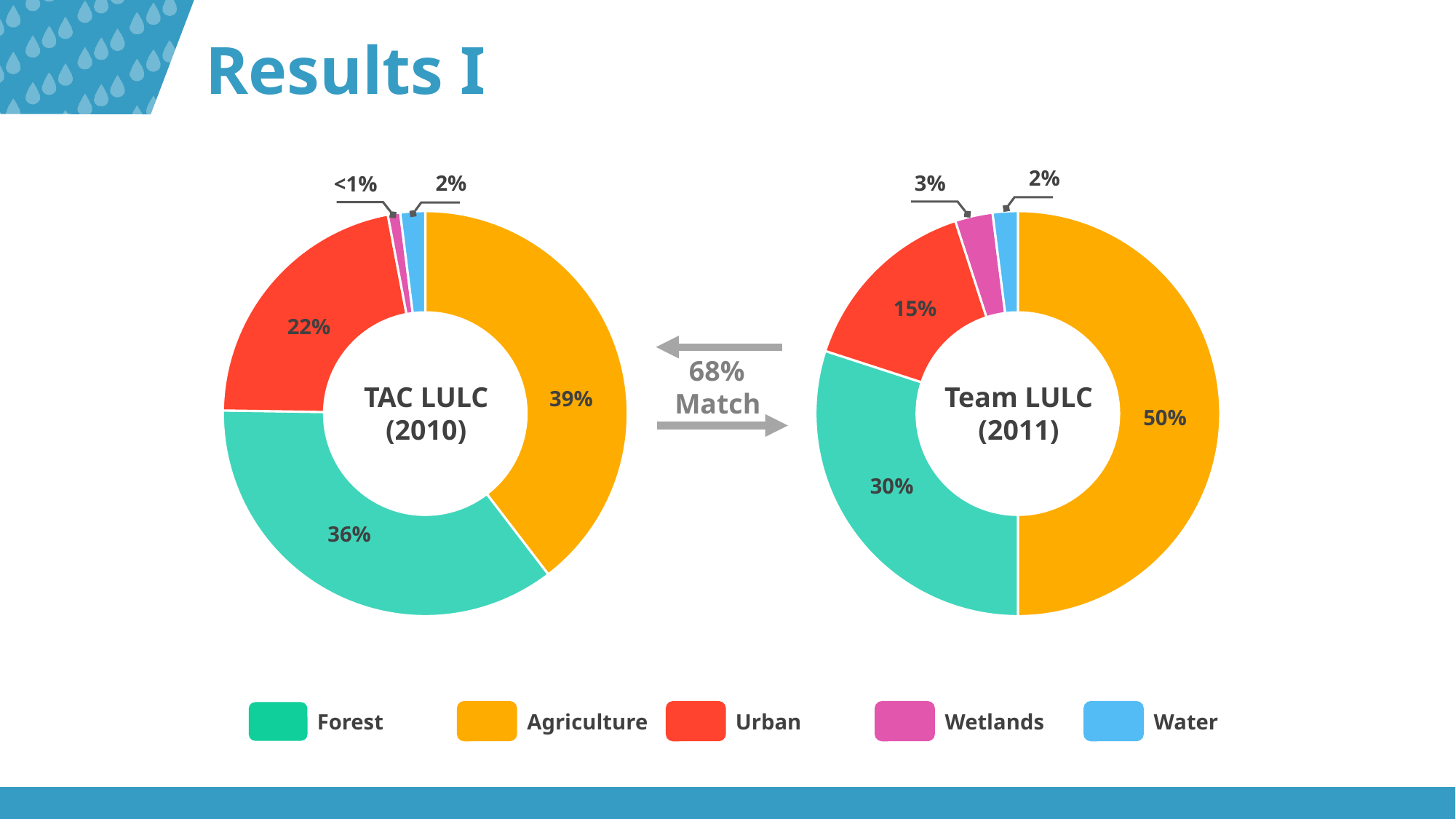
In the TAC LULC (2010) chart, what share is Agriculture? 39% What match percentage is shown between the two charts? 68% In the TAC LULC (2010) chart, what is the difference between the Forest and Urban shares? 14% In the TAC LULC (2010) chart, which category has the largest share? Agriculture In the TAC LULC (2010) chart, what share is Urban? 22% Which chart shows a larger Urban share, TAC LULC (2010) or Team LULC (2011)? TAC LULC (2010) How many categories does the legend list? 5 In the Team LULC (2011) chart, what share is Wetlands? 3% What kind of chart is the TAC LULC (2010) chart? Pie (donut) chart In the Team LULC (2011) chart, what share is Forest? 30% In the Team LULC (2011) chart, what is the difference between the Agriculture and Forest shares? 20% In the Team LULC (2011) chart, which category has the smallest share? Water